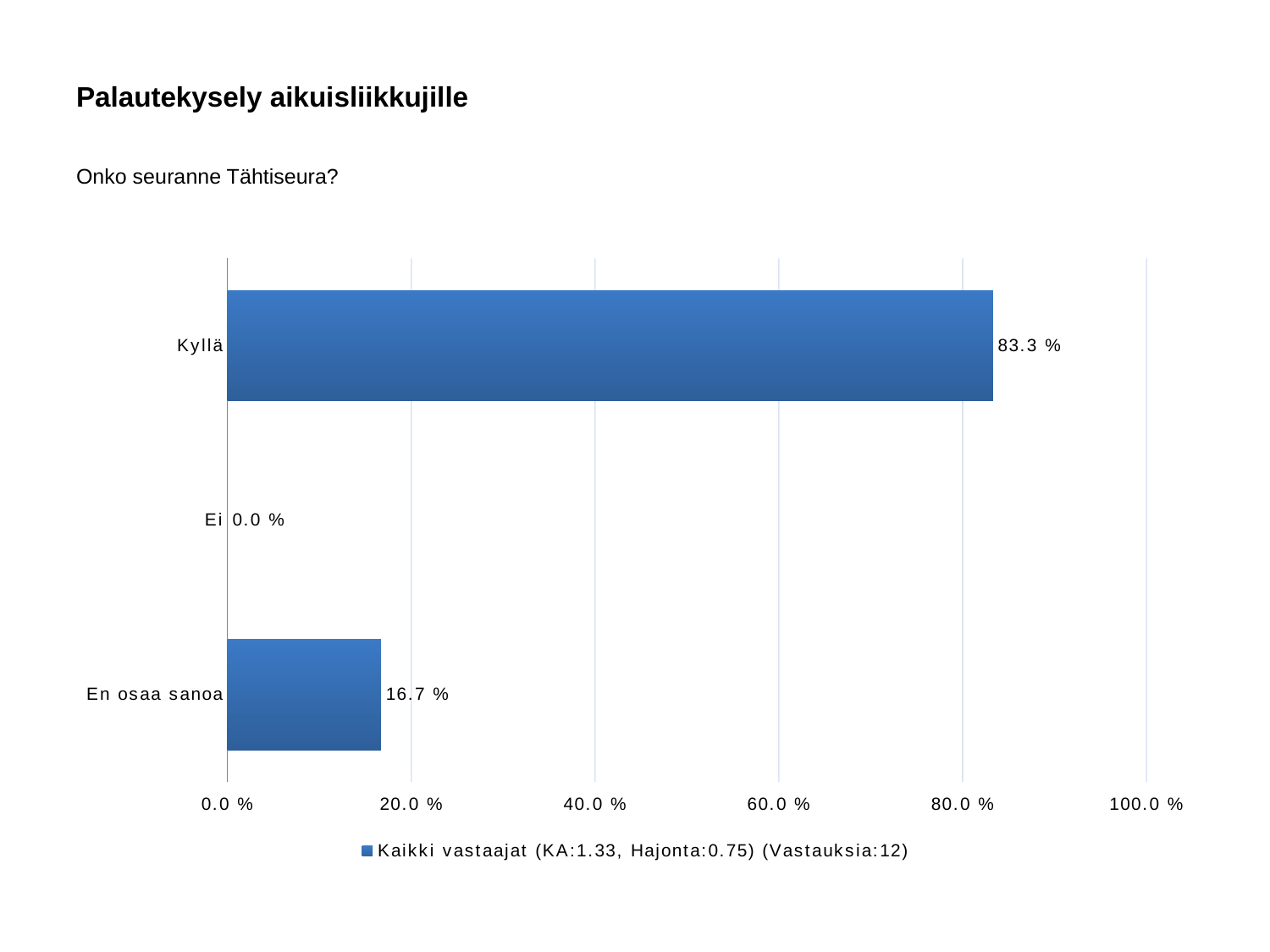
Is the value for Kyllä greater or less than 80.0 %? greater What is the value for Ei? 0.0 % What is the question shown above the chart? Onko seuranne Tähtiseura? What is the value for En osaa sanoa? 16.7 % What is the difference between the values for Kyllä and En osaa sanoa? 66.6 % What kind of chart is shown on the slide? bar chart What is the value for Kyllä? 83.3 % Which category has the highest value? Kyllä How many series does the legend list? 1 Which is larger, the value for Kyllä or the value for En osaa sanoa? Kyllä Which category has the lowest value? Ei How many categories are shown in the chart? 3